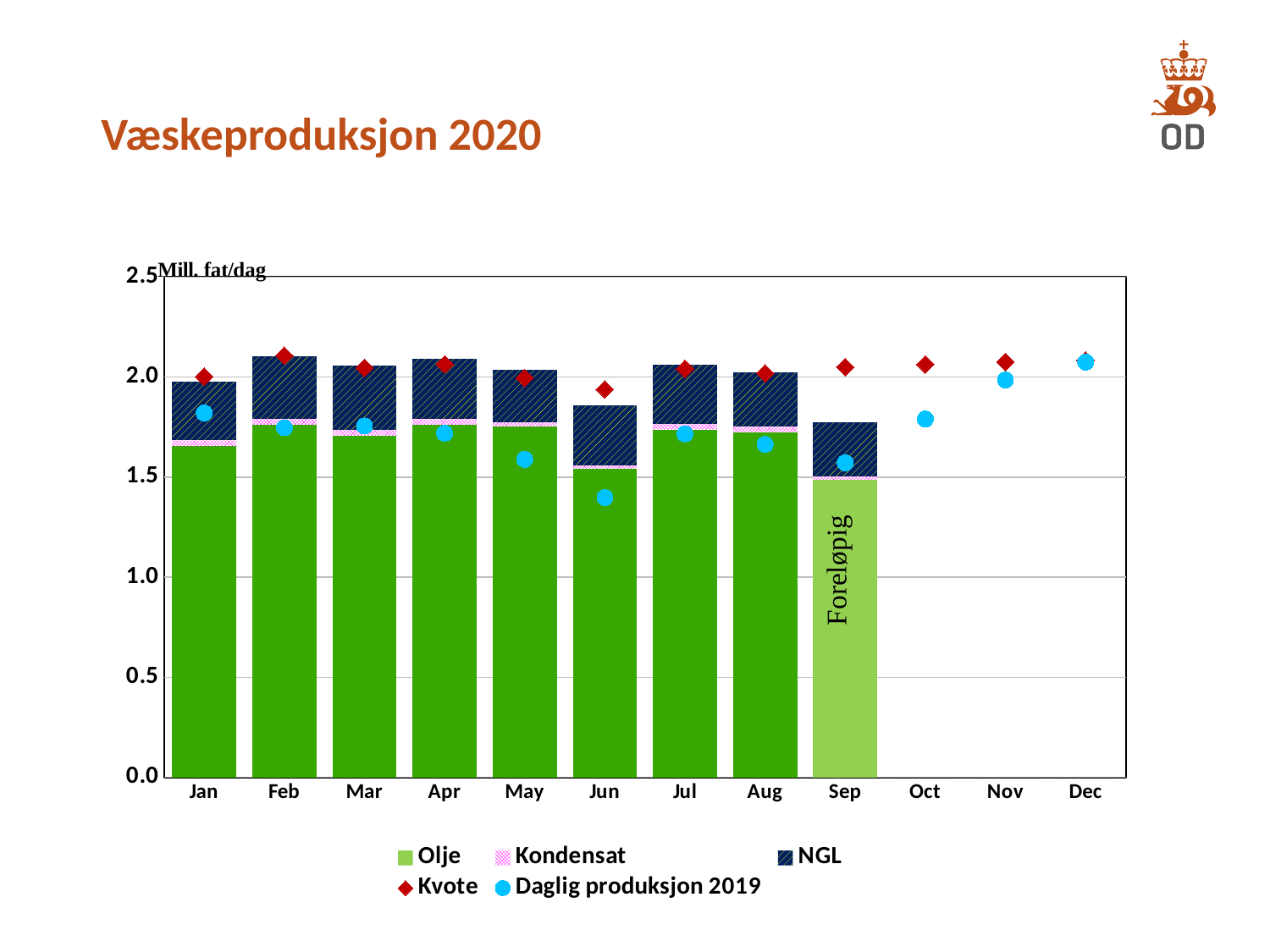
Is the Olje value for Jan greater or less than 1.5? greater Which is larger in Jun, the Kvote value or the Daglig produksjon 2019 value? Kvote How many months are shown on the x axis? 12 How many series does the legend list? 5 Is the total stacked bar for Jun greater or less than 2.0? less Is the Daglig produksjon 2019 value for Jun greater or less than 1.5? less What unit label is shown at the top of the y axis? Mill. fat/dag Which month has the tallest stacked bar? Feb Which month has the shortest stacked bar? Sep What kind of chart is shown on the slide? Stacked bar chart with point markers In which month is the Daglig produksjon 2019 value lowest? Jun How many months have a stacked bar plotted? 9